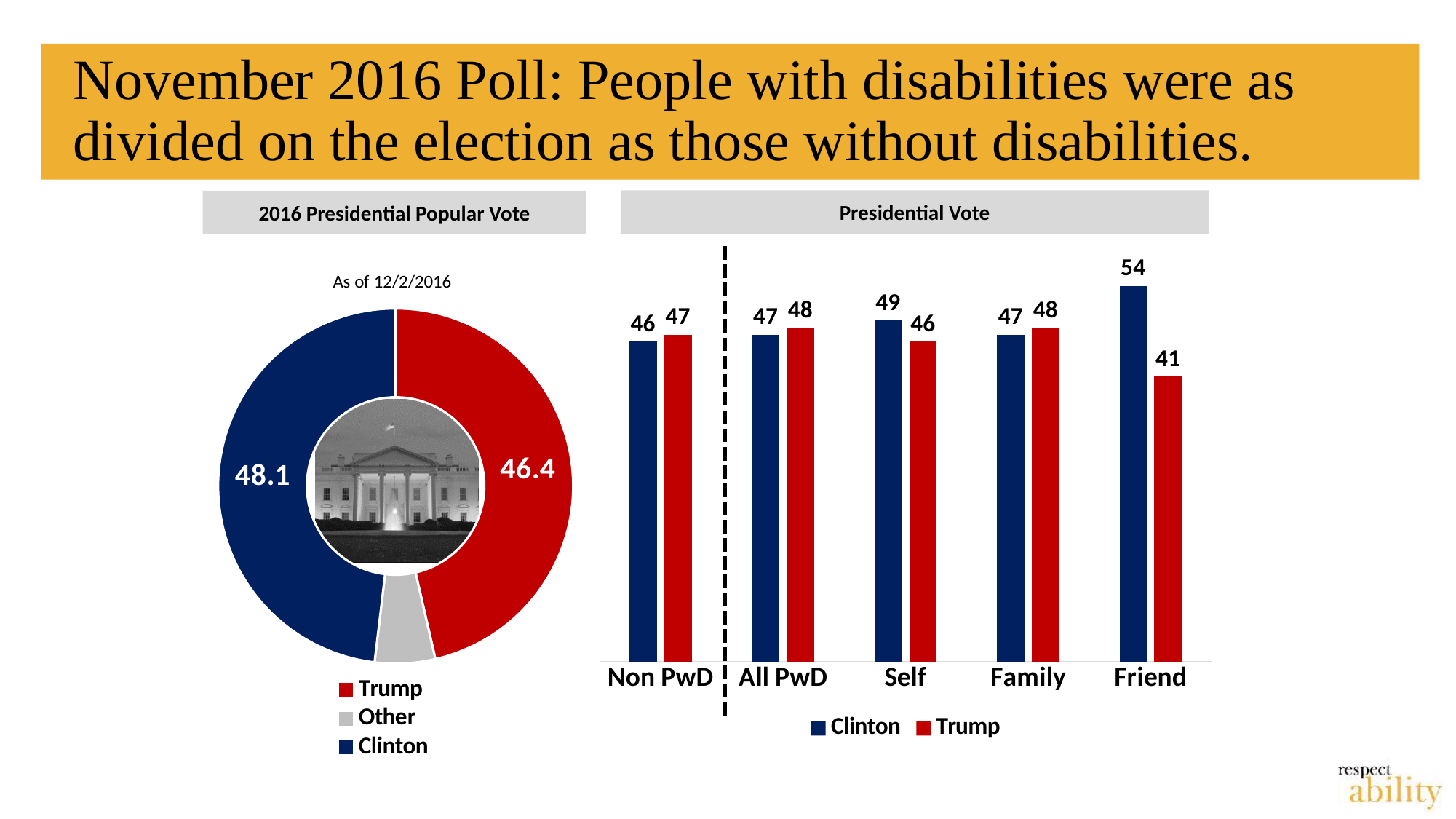
In the 'Presidential Vote' chart, what is the difference between the Clinton and Trump values for Friend? 13 In the 'Presidential Vote' chart, how many series does the legend list? 2 What kind of chart is the '2016 Presidential Popular Vote' chart? Pie chart (doughnut) In the 'Presidential Vote' chart, which category has the highest Clinton value? Friend In the '2016 Presidential Popular Vote' chart, what value is shown for Trump? 46.4 In the 'Presidential Vote' chart, what is the Trump value for Self? 46 In the '2016 Presidential Popular Vote' chart, what value is shown for Clinton? 48.1 In the 'Presidential Vote' chart, how many categories are shown on the x axis? 5 In the 'Presidential Vote' chart, what is the Clinton value for Friend? 54 In the 'Presidential Vote' chart, which category has the lowest Trump value? Friend In the '2016 Presidential Popular Vote' chart, how many categories does the legend list? 3 In the '2016 Presidential Popular Vote' chart, what is the difference between the Clinton and Trump values? 1.7